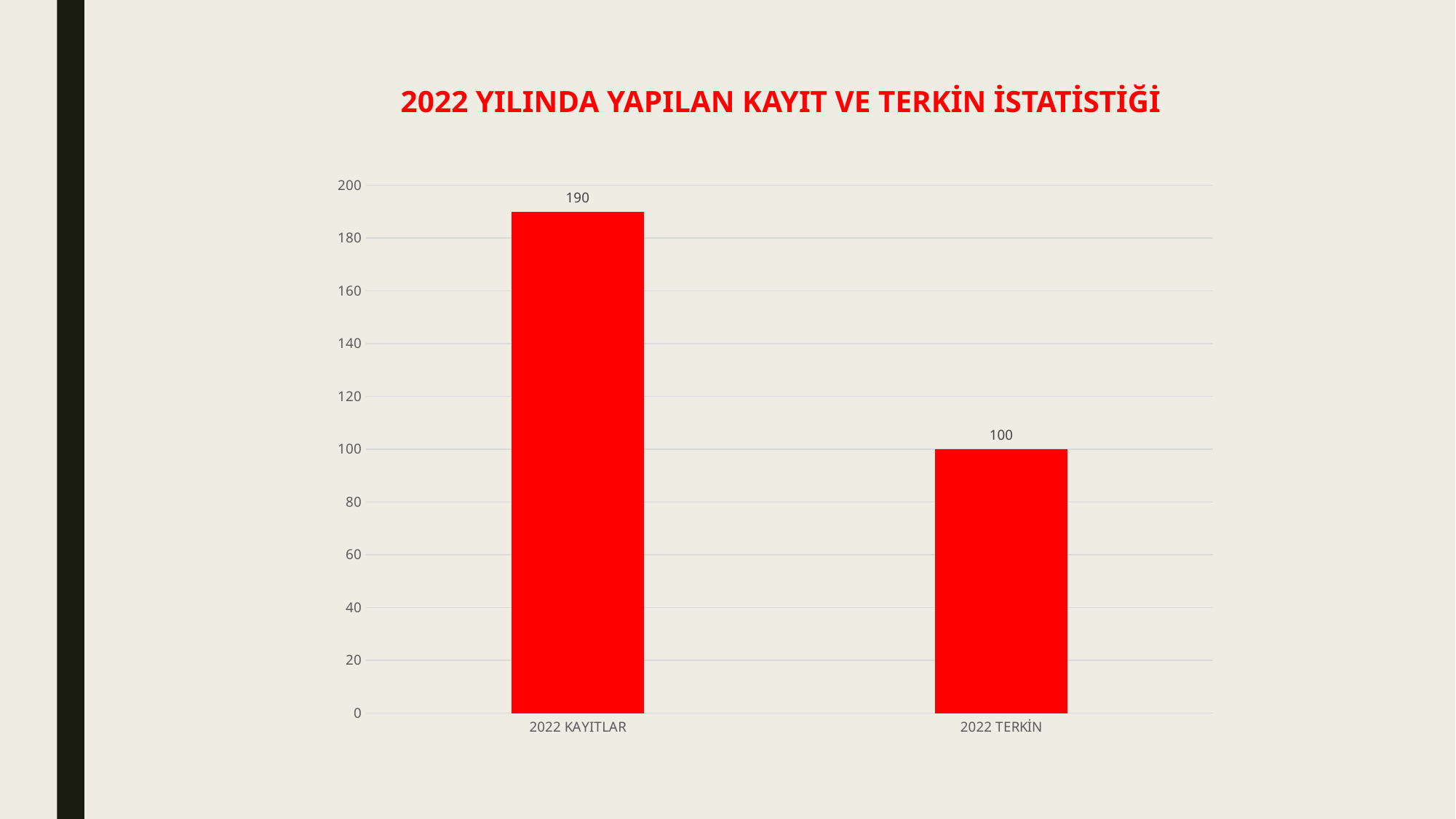
Is the value for 2022 KAYITLAR greater or less than 180? greater Which category has the highest value? 2022 KAYITLAR Which category has the lowest value? 2022 TERKİN What is the title of the chart? 2022 YILINDA YAPILAN KAYIT VE TERKİN İSTATİSTİĞİ What colour are the bars in the chart? red What kind of chart is shown on the slide? bar chart Which is larger, the value for 2022 KAYITLAR or the value for 2022 TERKİN? 2022 KAYITLAR How many categories are shown on the x axis? 2 What is the value for 2022 TERKİN? 100 Is the value for 2022 TERKİN greater or less than 120? less What is the value for 2022 KAYITLAR? 190 What is the difference between the values for 2022 KAYITLAR and 2022 TERKİN? 90